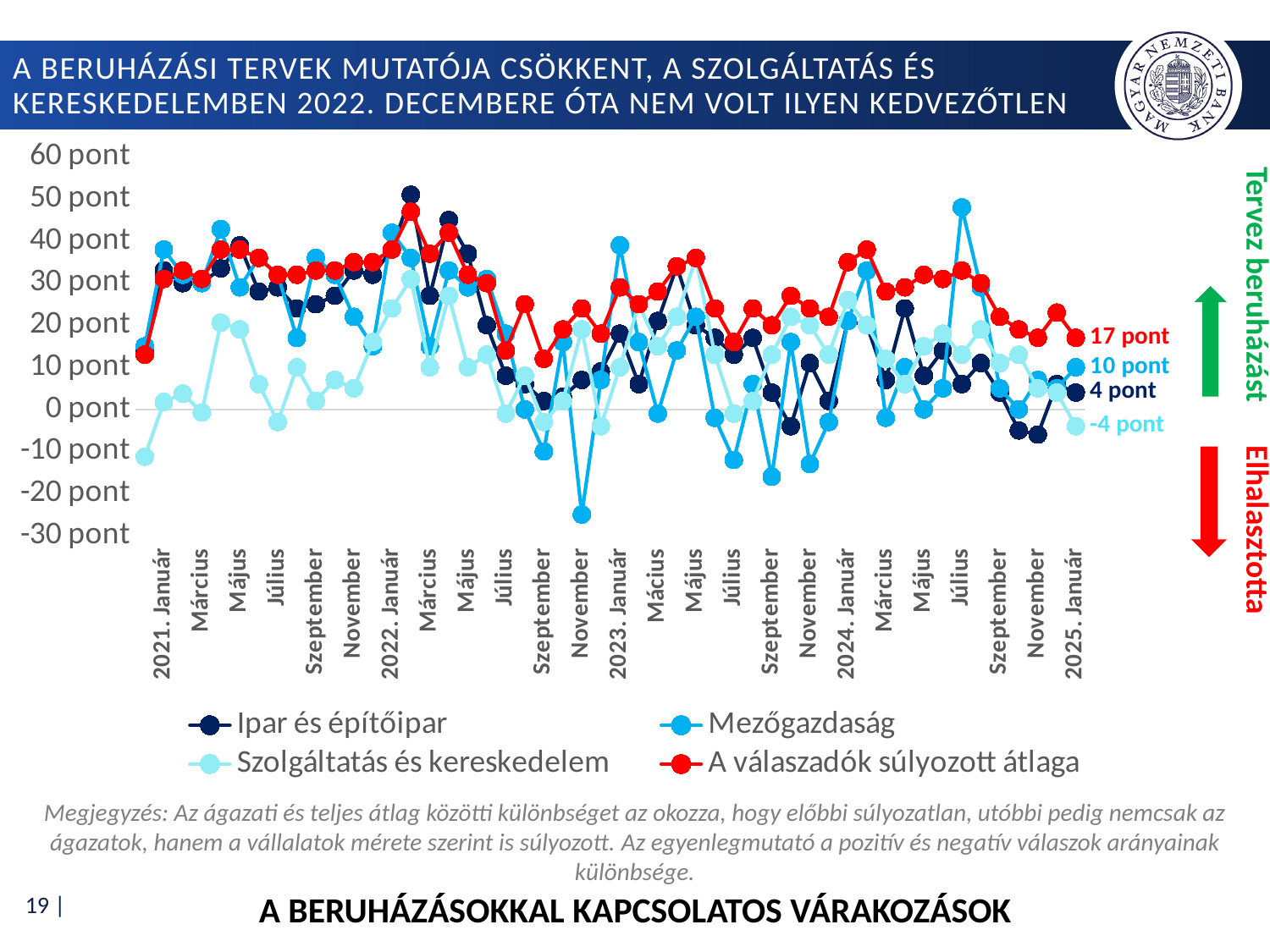
What is the value of Mezőgazdaság at 2025. Január? 10 pont At 2025. Január, which is larger: Mezőgazdaság or Ipar és építőipar? Mezőgazdaság Which series has the lowest value at 2025. Január? Szolgáltatás és kereskedelem What is the value of A válaszadók súlyozott átlaga at 2025. Január? 17 pont Which series has the highest value at 2025. Január? A válaszadók súlyozott átlaga Is the value for Mezőgazdaság at 2024. Július greater or less than 40 pont? greater What is the value of Ipar és építőipar at 2025. Január? 4 pont How many series does the legend list? 4 What kind of chart is shown on the slide? Line chart What colour is the line for A válaszadók súlyozott átlaga? Red What is the difference between A válaszadók súlyozott átlaga and Szolgáltatás és kereskedelem at 2025. Január? 21 pont What is the value of Szolgáltatás és kereskedelem at 2025. Január? -4 pont